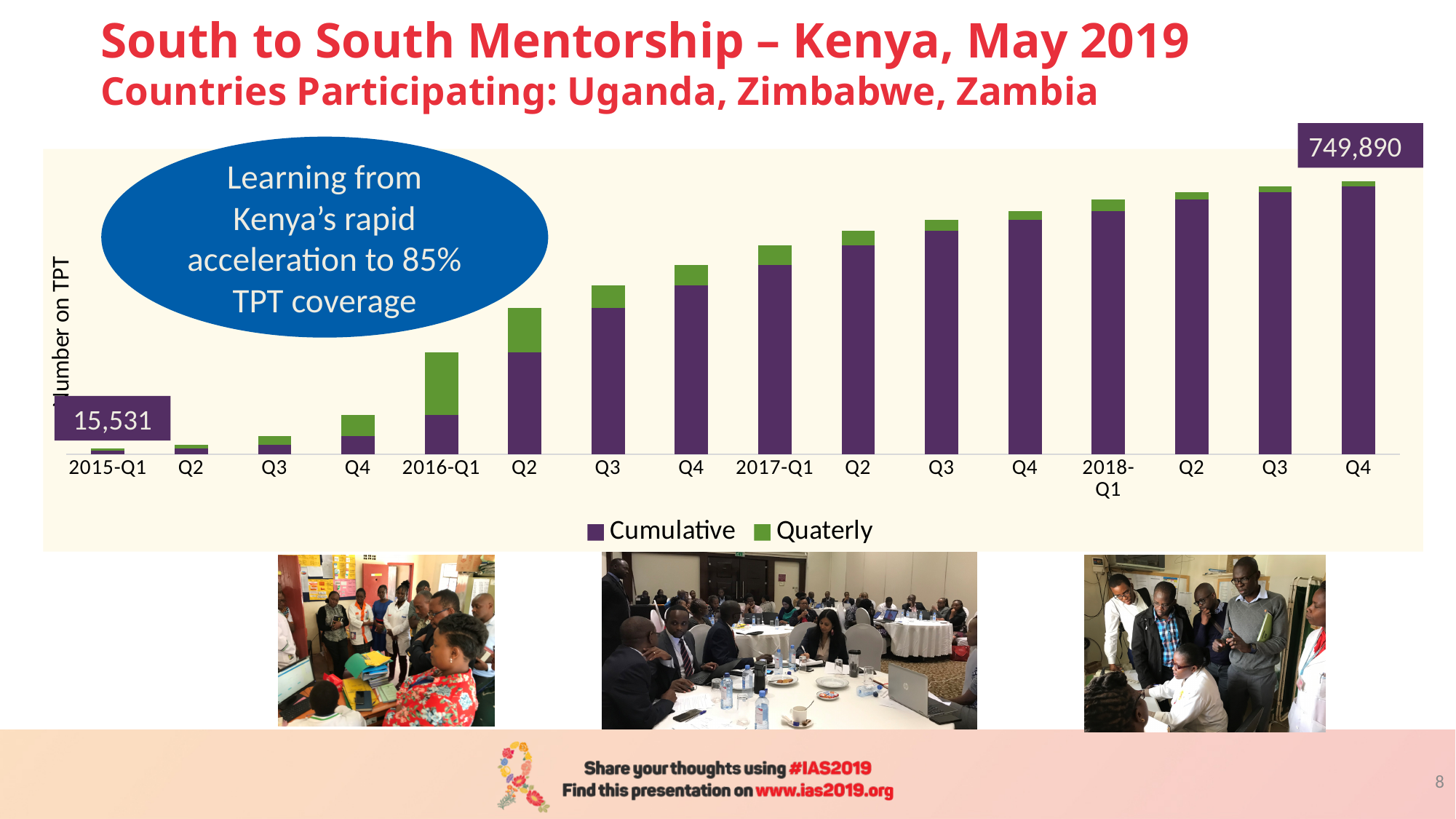
What value is labelled on the chart for 2018-Q4? 749,890 Which colour represents the Cumulative series in the chart? purple Which quarter has the highest Cumulative value? 2018-Q4 What value is labelled on the chart for 2015-Q1? 15,531 Which quarter has the largest Quaterly segment? 2016-Q1 What kind of chart is shown on the slide? bar chart Is the Cumulative value larger for 2016-Q1 or for 2017-Q1? 2017-Q1 Does the Cumulative series rise or fall from 2015-Q1 to 2018-Q4? rise What are the two series named in the chart legend? Cumulative and Quaterly How many series does the chart legend list? 2 Which quarter has the lowest Cumulative value? 2015-Q1 How many quarters are shown along the x axis of the chart? 16